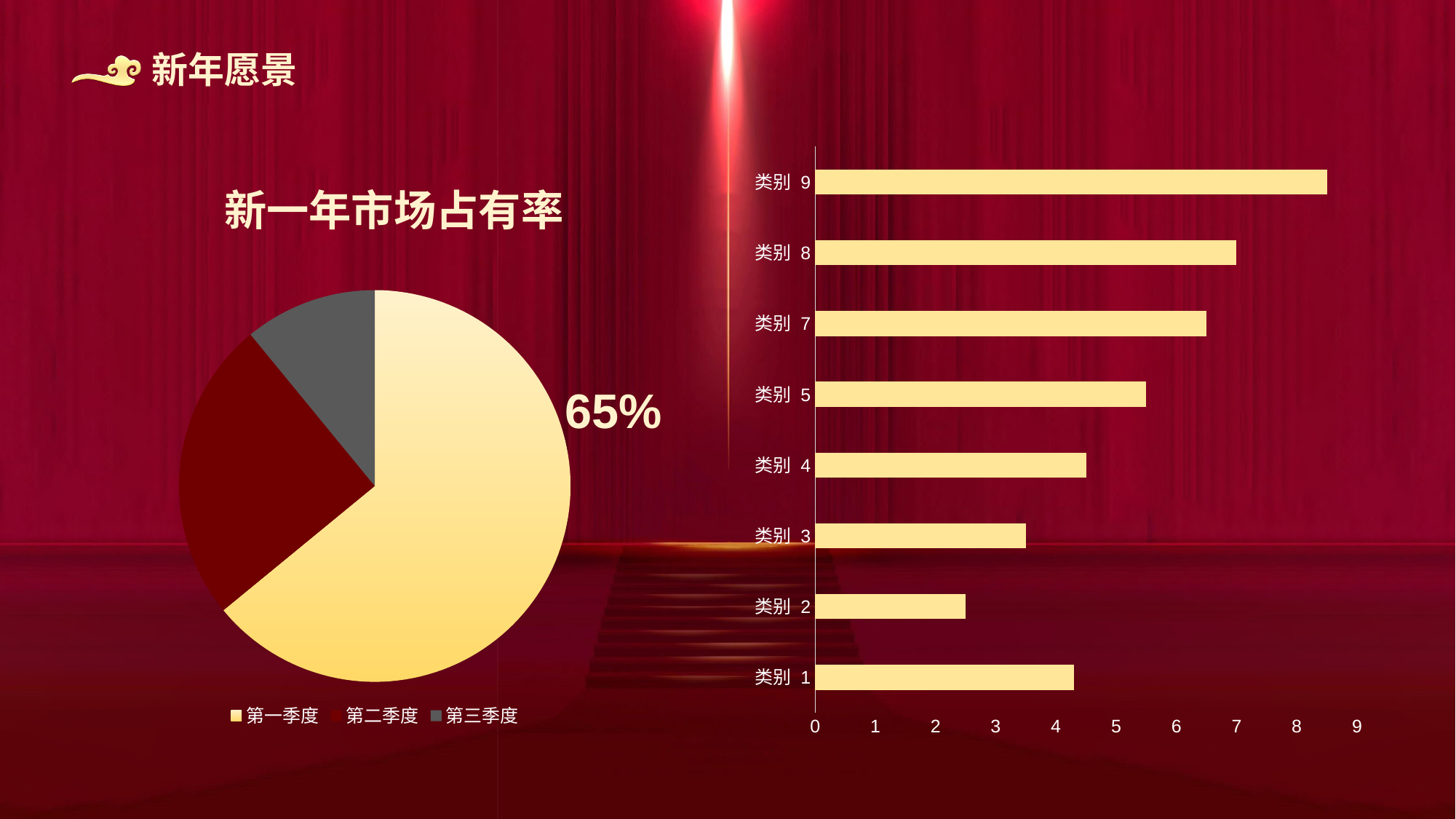
In the bar chart on the right, which is larger, the value for 类别 8 or the value for 类别 3? 类别 8 How many categories does the bar chart on the right show? 8 How many entries does the legend of the pie chart on the left list? 3 In the bar chart on the right, which category has the highest value? 类别 9 In the pie chart on the left, which slice is the largest? 第一季度 In the pie chart on the left, what share is shown for 第一季度? 65% In the pie chart on the left, which slice is the smallest? 第三季度 What is the title of the pie chart on the left? 新一年市场占有率 In the bar chart on the right, which category has the lowest value? 类别 2 What kind of chart is the chart on the right of the slide? bar chart In the bar chart on the right, is the value for 类别 9 greater or less than 8? greater What kind of chart is the chart on the left of the slide? pie chart